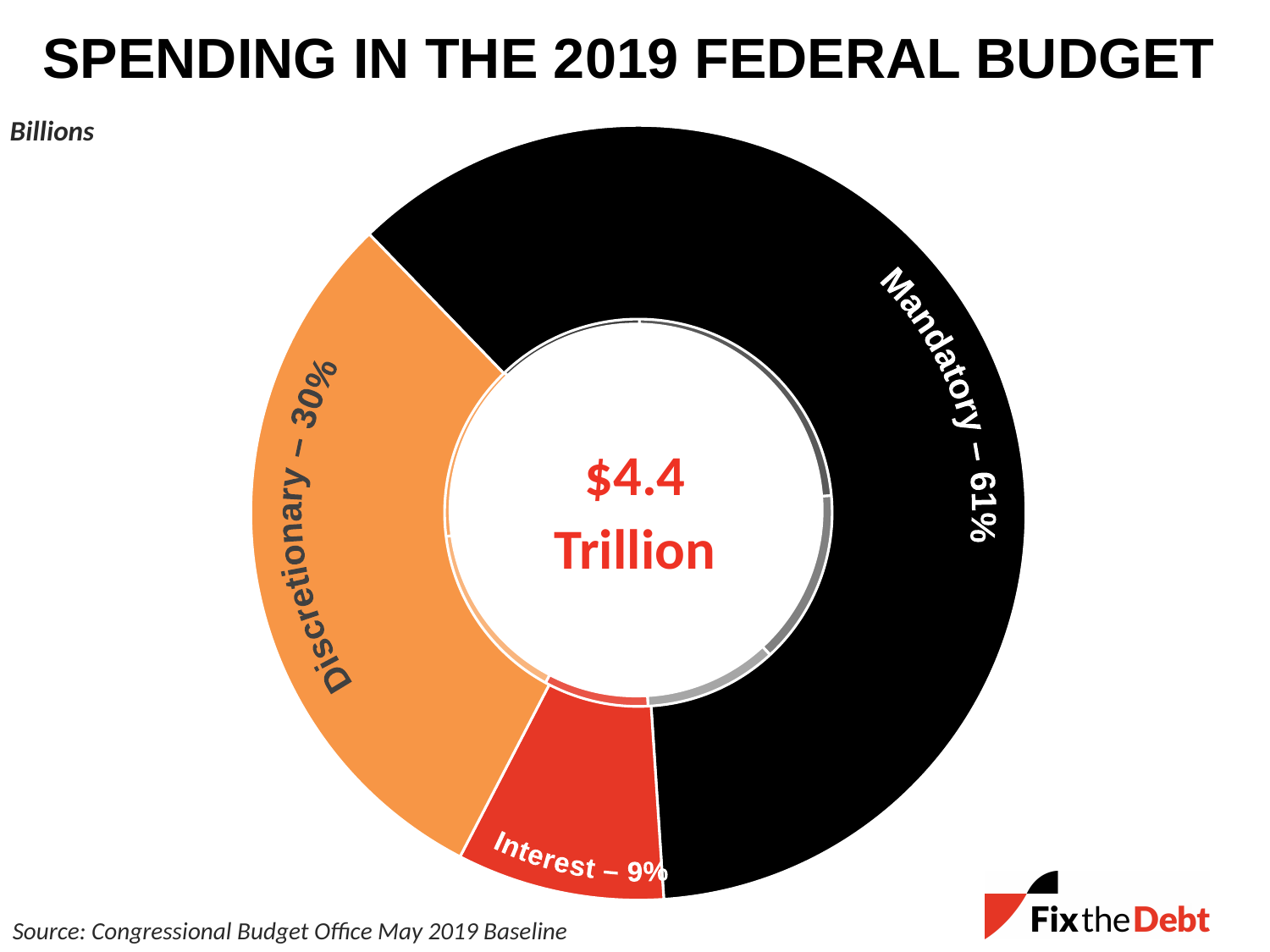
What share of the 2019 federal budget spending is Discretionary? 30% Which spending category has the smallest share of the 2019 federal budget? Interest What colour is the Discretionary slice of the chart? Orange What total spending amount is shown in the center of the chart? $4.4 Trillion How many percentage points larger is the Mandatory share than the Discretionary share? 31 What kind of chart is shown on the slide? Pie chart (donut) How many spending categories are shown in the chart? 3 Which is larger, the Discretionary share or the Interest share? Discretionary Which spending category has the largest share of the 2019 federal budget? Mandatory How many percentage points larger is the Discretionary share than the Interest share? 21 What share of the 2019 federal budget spending is Mandatory? 61% What share of the 2019 federal budget spending is Interest? 9%